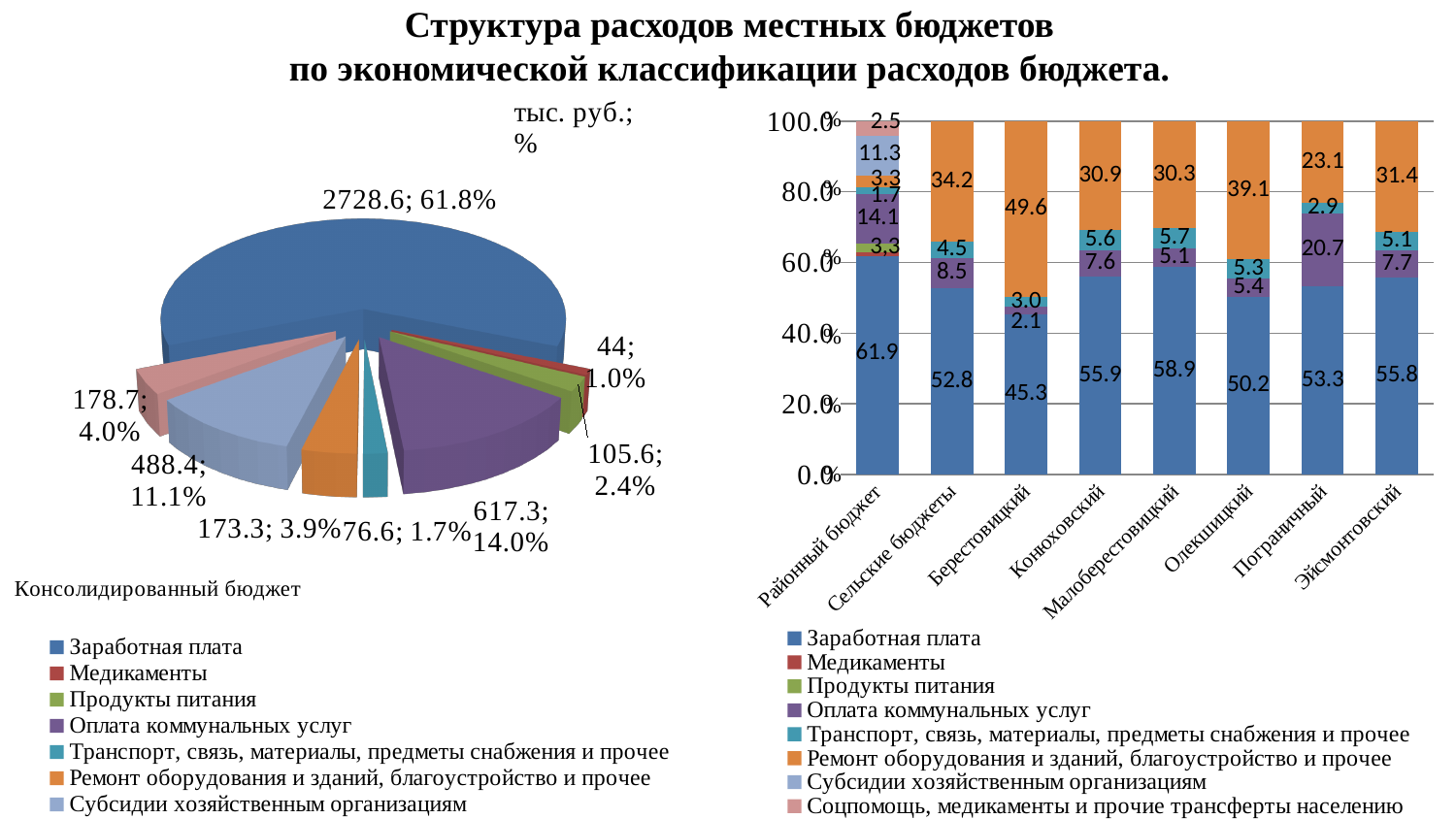
In the pie chart on the left, what is the value shown for the slice labelled 488.4? 488.4; 11.1% In the stacked bar chart on the right, what is the difference between the Заработная плата values for Малоберестовицкий (58.9) and Олекшицкий (50.2)? 8.7 In the stacked bar chart on the right, which is larger: the Ремонт оборудования и зданий value for Берестовицкий or for Пограничный? Берестовицкий How many categories are shown on the x axis of the stacked bar chart on the right? 8 How many series does the legend of the pie chart on the left list? 7 In the stacked bar chart on the right, what is the value of Заработная плата for Берестовицкий? 45.3 In the stacked bar chart on the right, which category has the highest value for Заработная плата? Районный бюджет In the stacked bar chart on the right, which category has the lowest value for Заработная плата? Берестовицкий What kind of chart is the chart on the right of the slide? stacked bar chart In the pie chart on the left, what value and share are shown for the largest slice (Заработная плата)? 2728.6; 61.8% What kind of chart is the chart on the left of the slide (Консолидированный бюджет)? pie chart In the pie chart on the left, what share of the pie does the Оплата коммунальных услуг slice (617.3) have? 14.0%